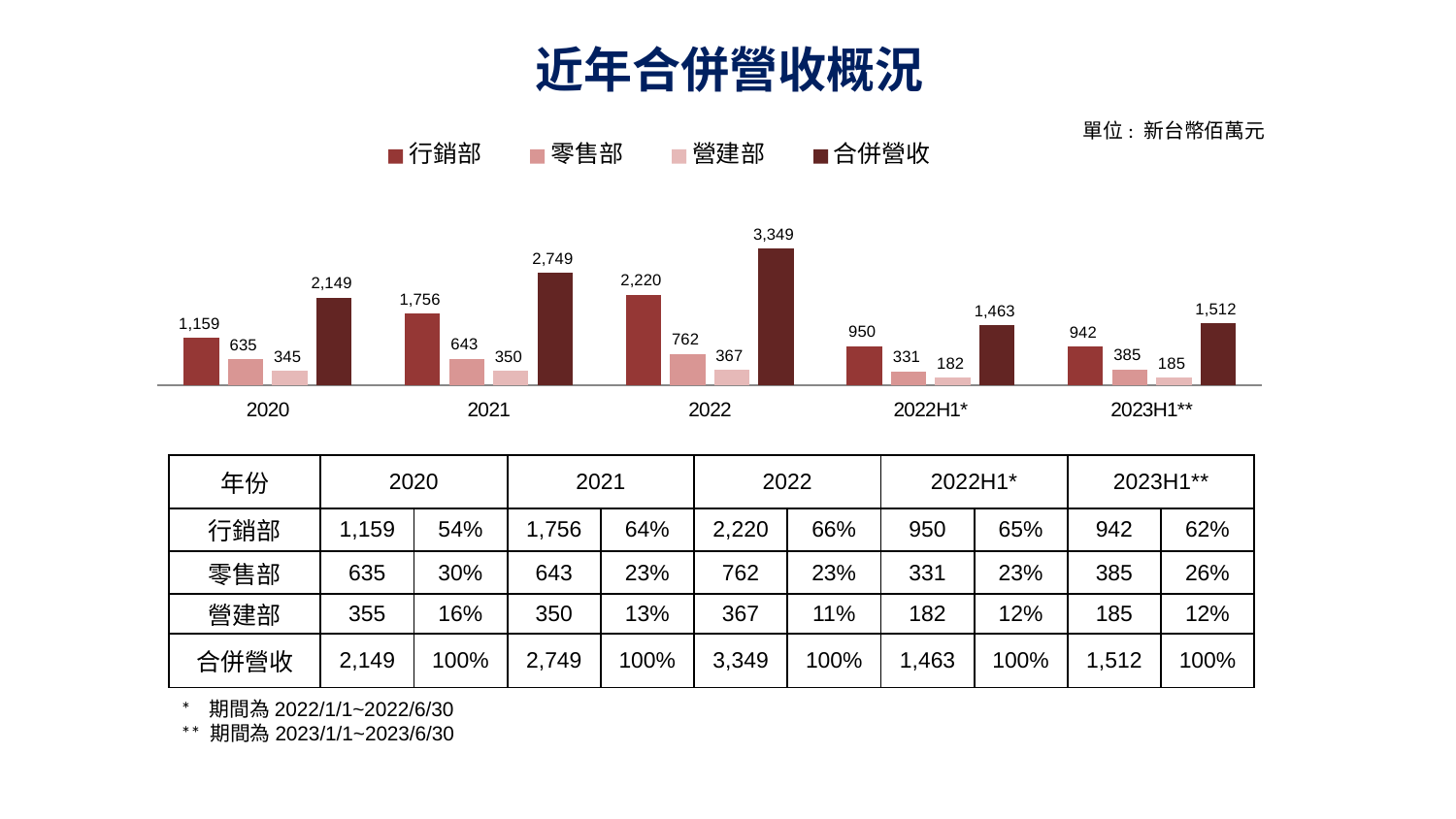
What is the value for 營建部 in 2022H1*? 182 Which category has the lowest value for 行銷部? 2023H1** How many series does the legend list? 4 How many categories are shown on the x axis? 5 What is the difference between 合併營收 in 2021 and 2020? 600 Which is larger: 零售部 in 2022 or 零售部 in 2021? 2022 What is the title of the chart? 近年合併營收概況 What is the value for 零售部 in 2023H1**? 385 What is the value for 合併營收 in 2022? 3,349 What is the value for 行銷部 in 2021? 1,756 Which year has the highest 合併營收? 2022 What kind of chart is shown? bar chart